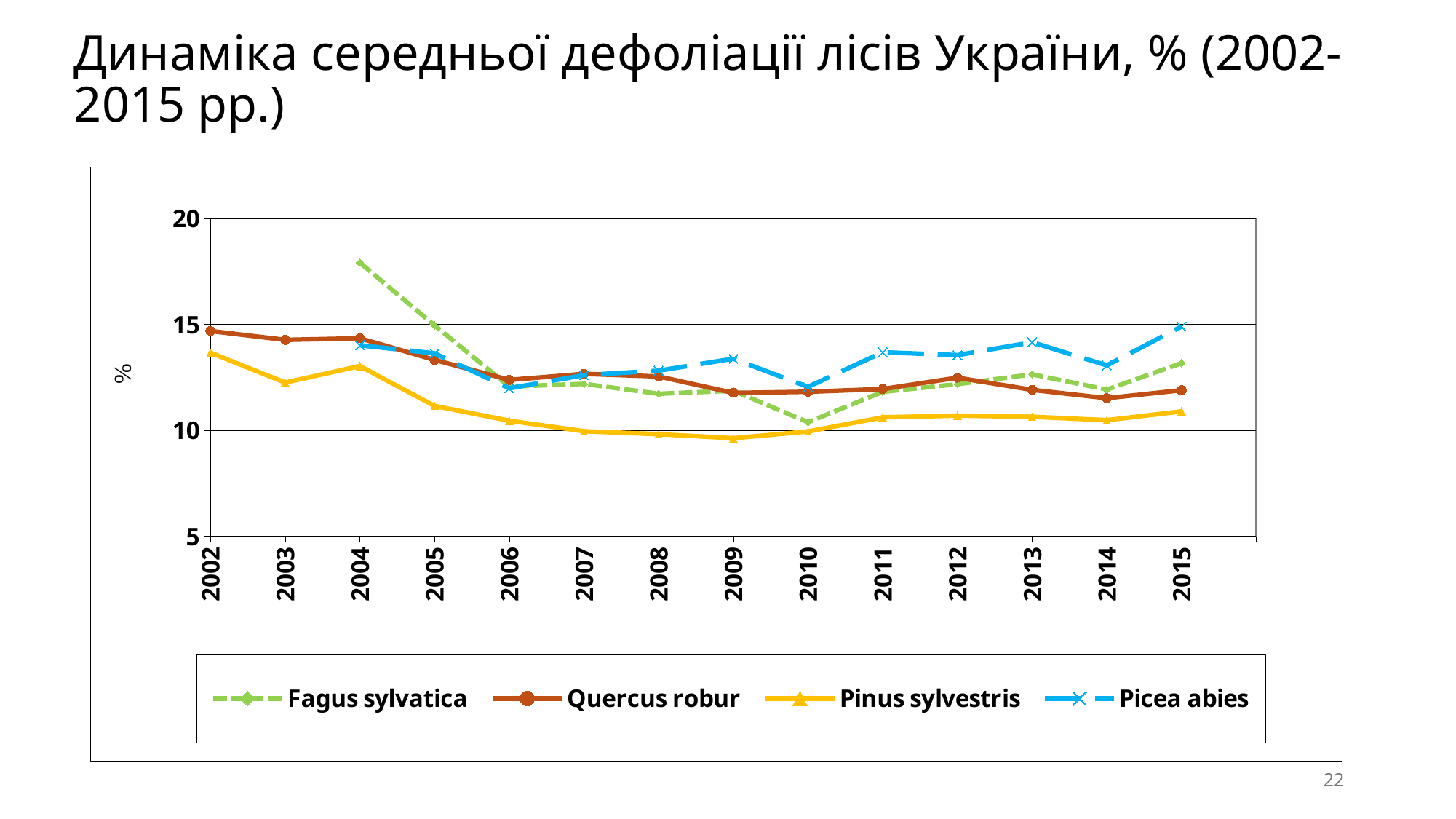
Which series has the highest value in 2015? Picea abies Does the Pinus sylvestris line rise or fall from 2002 to 2009? fall What kind of chart is shown on the slide? line chart Is the value for Fagus sylvatica in 2004 greater or less than 15? greater Is the value for Quercus robur in 2010 greater or less than 15? less How many series does the legend list? 4 Is the value for Pinus sylvestris in 2009 greater or less than 10? less In 2015, which is larger: Picea abies or Pinus sylvestris? Picea abies In 2005, which is larger: Quercus robur or Pinus sylvestris? Quercus robur How many years are shown on the x axis? 14 Which series has the lowest value in 2009? Pinus sylvestris What is the label on the y axis? %